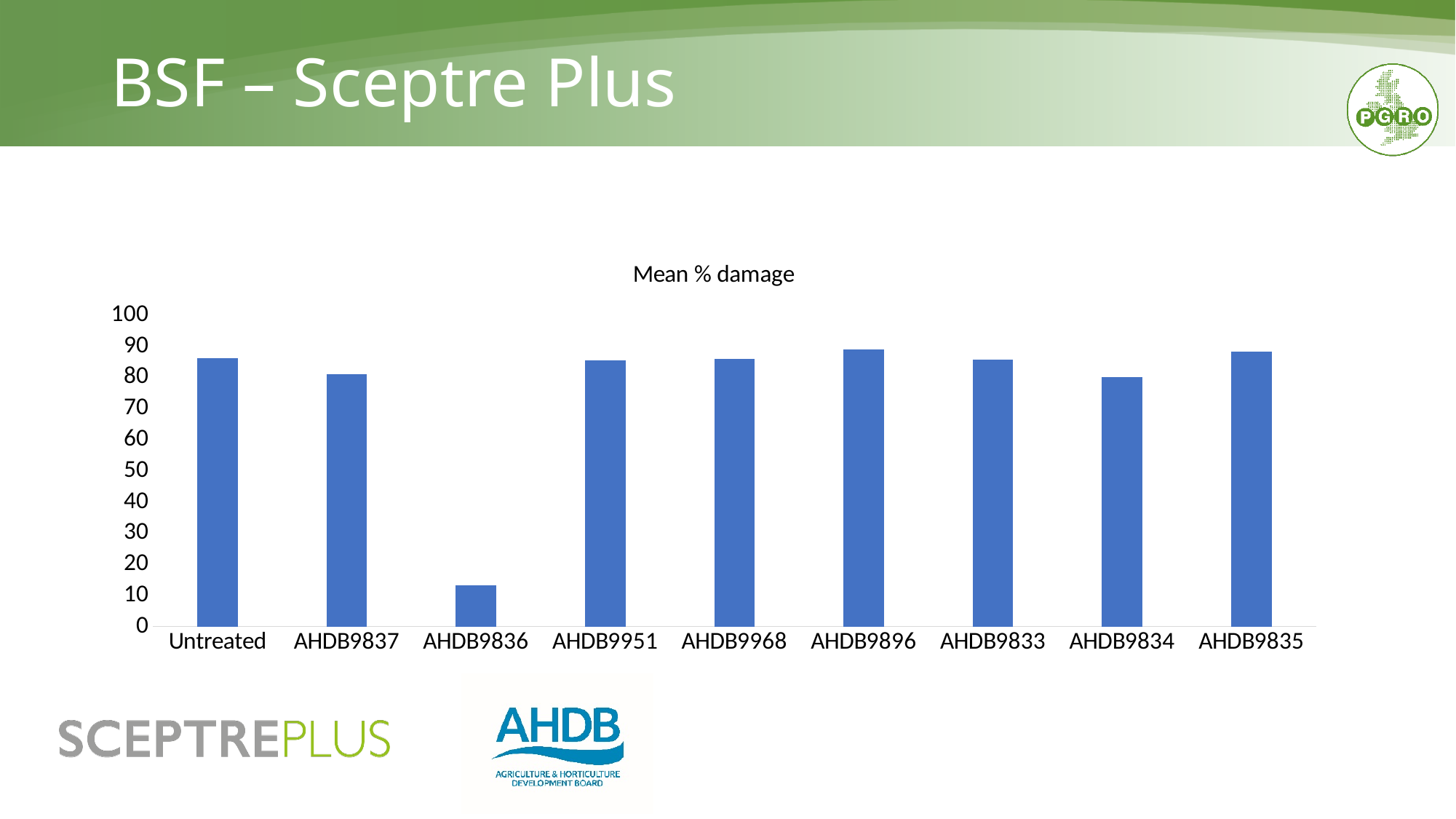
Is the value for AHDB9896 greater or less than 80? greater Which has the larger mean % damage, AHDB9837 or AHDB9896? AHDB9896 What colour are the bars in the chart? blue Is the value for AHDB9836 greater or less than 20? less Which category has the lowest mean % damage? AHDB9836 Which has the larger mean % damage, AHDB9836 or AHDB9951? AHDB9951 Is the value for AHDB9834 greater or less than 70? greater How many categories are plotted on the x axis of the chart? 9 What is the title of the chart? Mean % damage What kind of chart is shown on the slide? bar chart